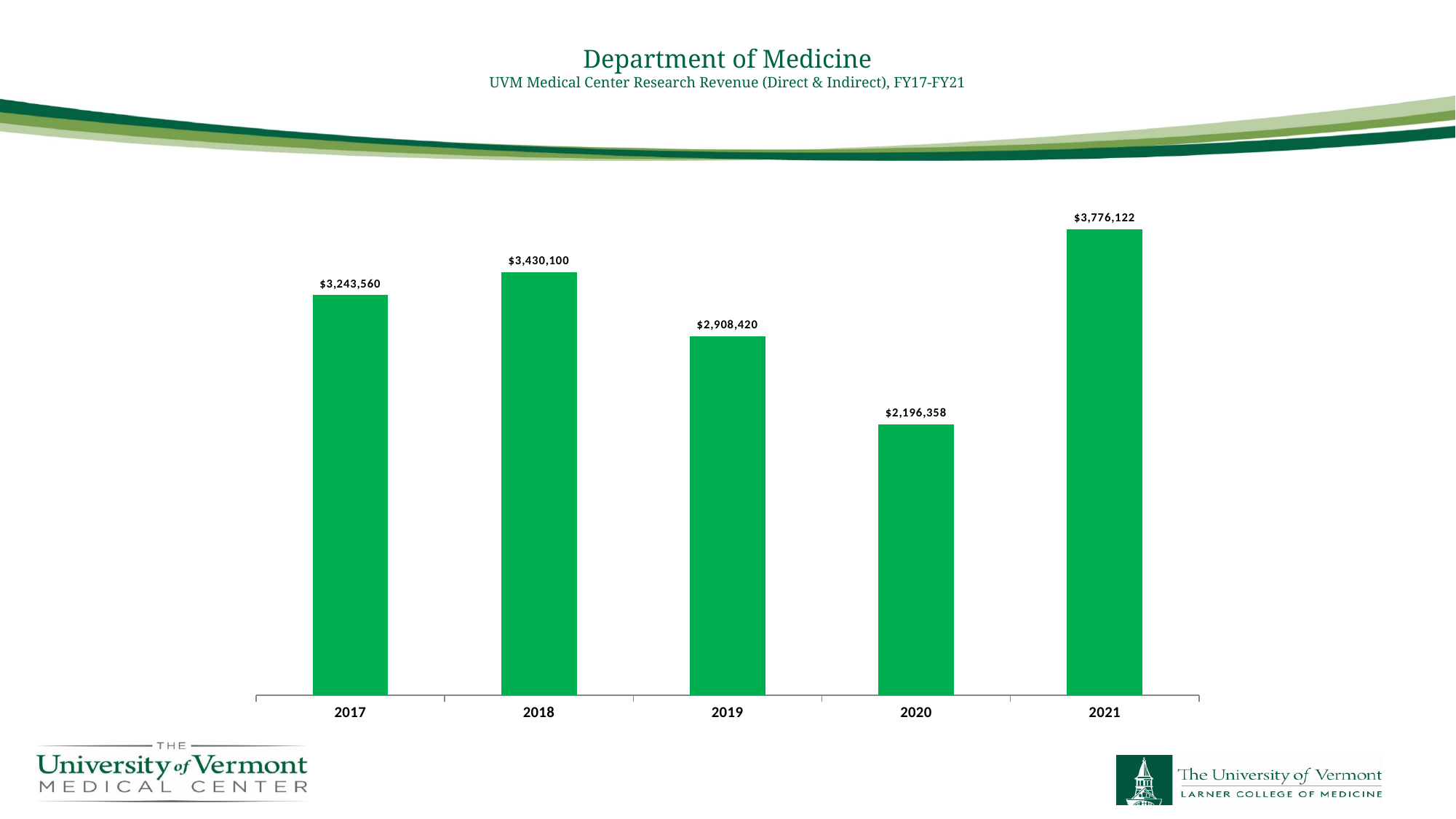
Which year has the highest research revenue? 2021 What is the difference in research revenue between 2021 and 2020? $1,579,764 What is the difference in research revenue between 2018 and 2017? $186,540 How many years are shown on the chart? 5 Did research revenue rise or fall from 2019 to 2020? Fall What is the research revenue for 2021? $3,776,122 What is the research revenue for 2017? $3,243,560 What is the research revenue for 2018? $3,430,100 What is the research revenue for 2020? $2,196,358 Which year has the lowest research revenue? 2020 Which year has higher research revenue, 2019 or 2017? 2017 What kind of chart is shown on the slide? Bar chart